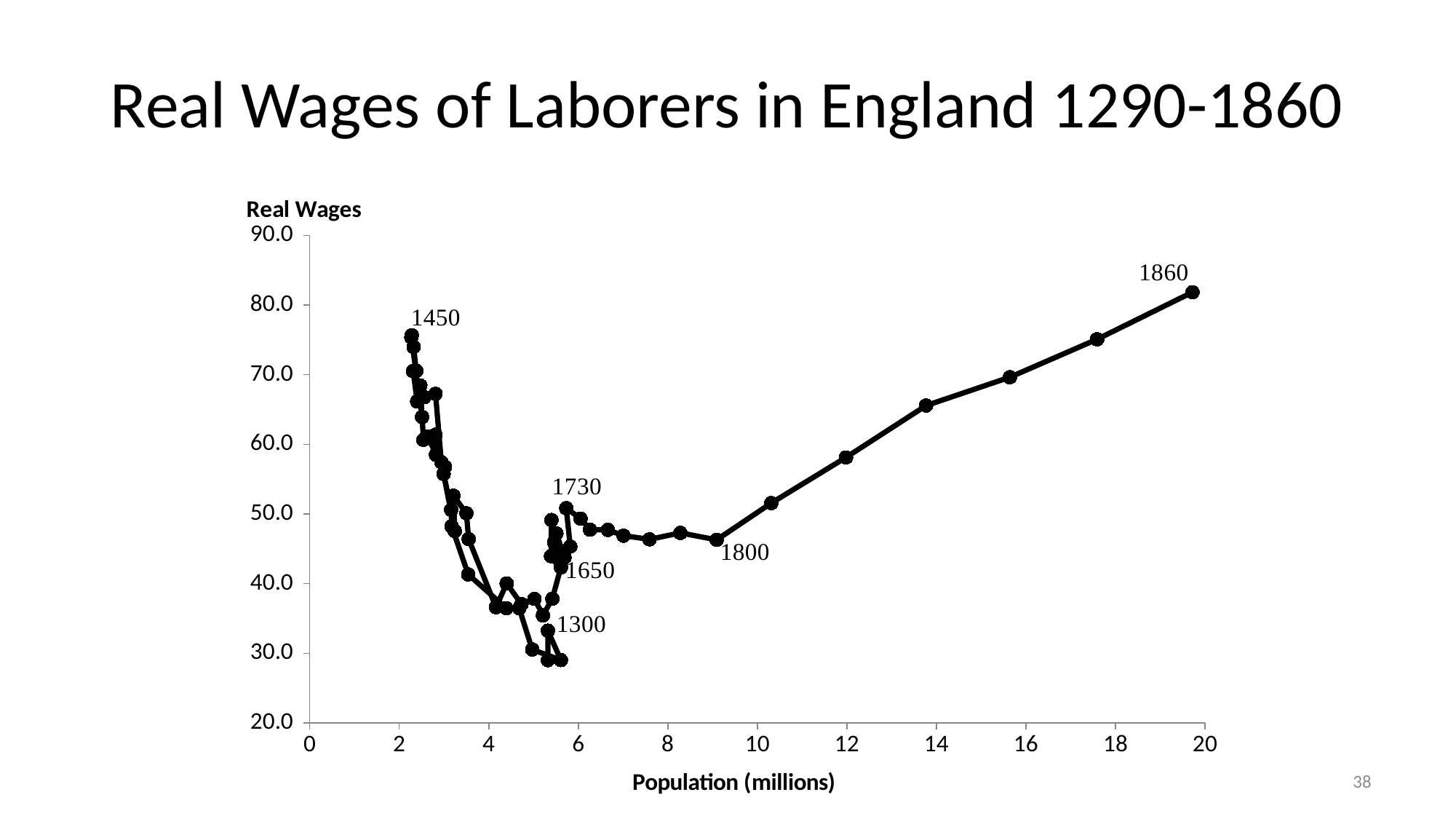
Is the real wage value at the point labeled 1860 greater or less than 70? greater Is the real wage value at the point labeled 1300 greater or less than 40? less Between the points labeled 1800 and 1860, do real wages rise or fall as population increases? rise Among the labeled years on the chart, which has the highest real wages? 1860 Is the population at the point labeled 1860 greater or less than 18 million? greater Which labeled year has higher real wages, 1450 or 1730? 1450 What is the title of the chart? Real Wages of Laborers in England 1290-1860 What kind of chart is shown on the slide? line chart What is the label of the horizontal axis? Population (millions)